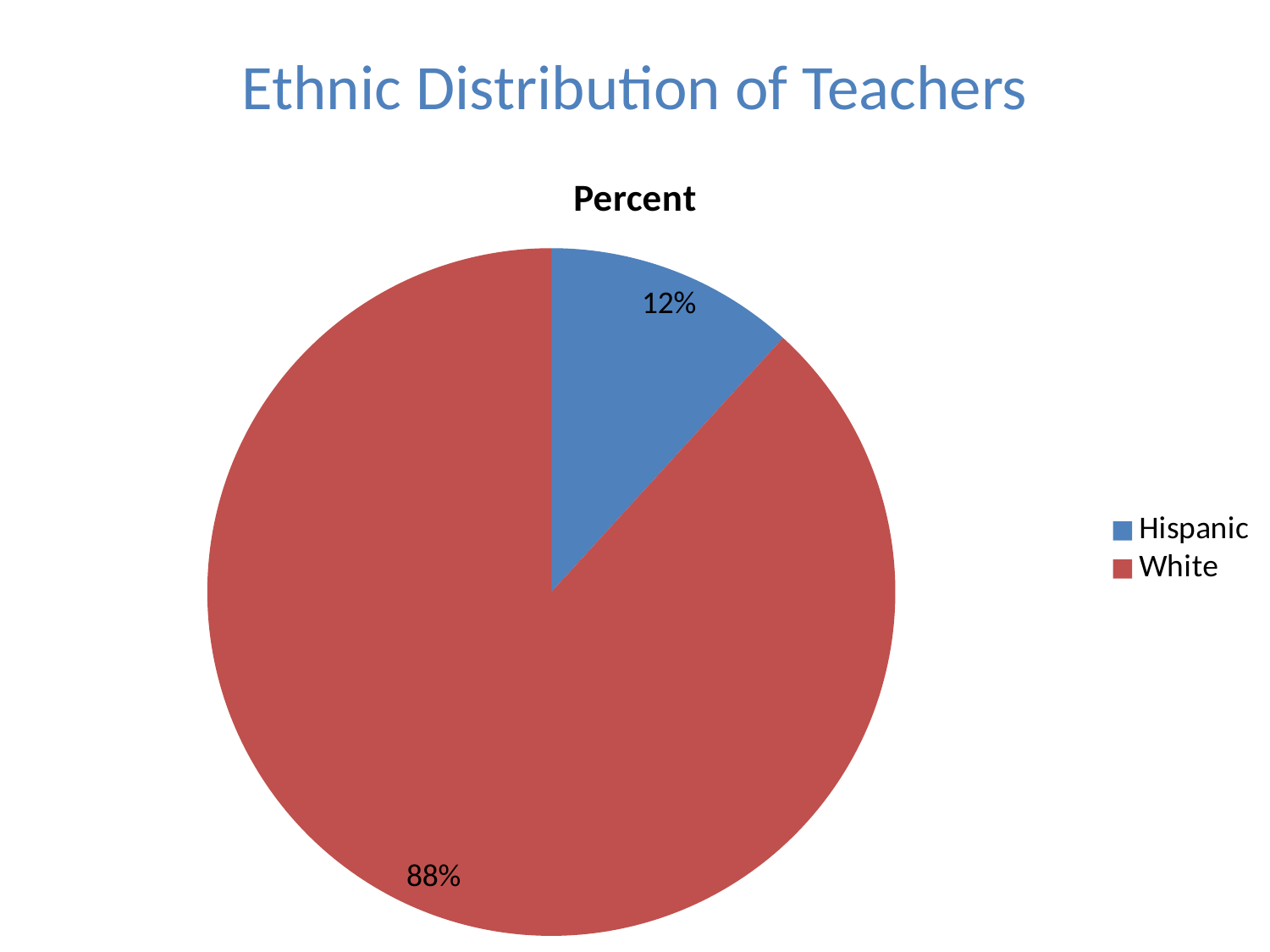
What colour is the Hispanic slice? Blue What is the difference in percentage points between the White and Hispanic shares? 76 What is the title of the chart? Percent Which ethnic group has the largest share of the pie? White What percentage of teachers are Hispanic? 12% How many entries does the legend list? 2 What percentage of teachers are White? 88% How many categories does the pie chart show? 2 What share of the pie does the White slice represent? 88% What kind of chart is shown on the slide? Pie chart Which is larger, the Hispanic share or the White share? White Which ethnic group has the smallest share of the pie? Hispanic